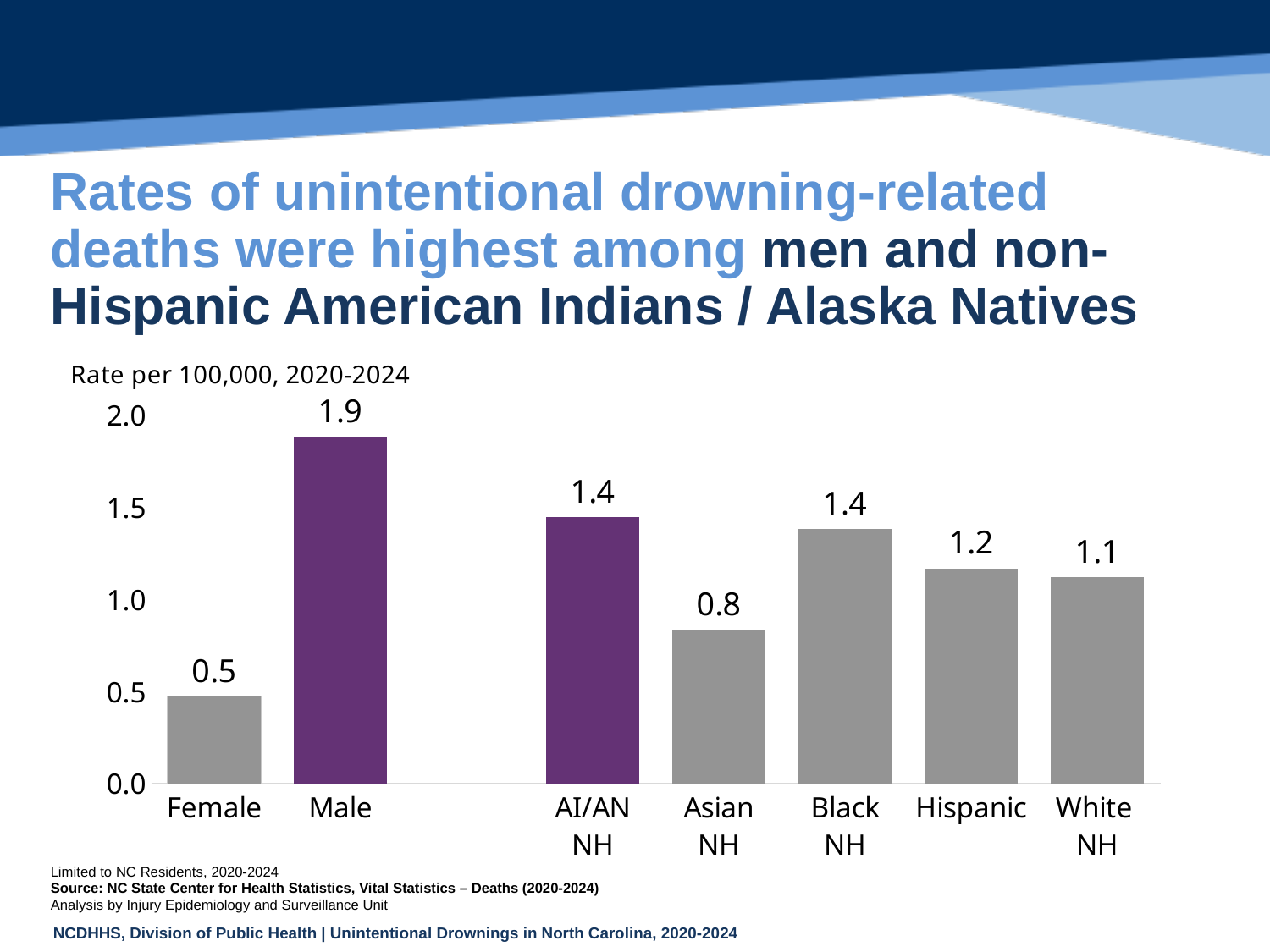
What is the rate per 100,000 for Hispanic? 1.2 What kind of chart is shown on the slide? Bar chart What is the rate per 100,000 for Asian NH? 0.8 What is the rate per 100,000 for White NH? 1.1 What is the difference between the Black NH and Asian NH rates? 0.6 Which category has the lowest rate? Female What is the difference between the Male and Female rates? 1.4 Which has a higher rate, Hispanic or White NH? Hispanic Which two bars are coloured purple? Male and AI/AN NH Which category has the highest rate? Male How many categories are shown on the x axis? 7 What is the rate per 100,000 for Male? 1.9